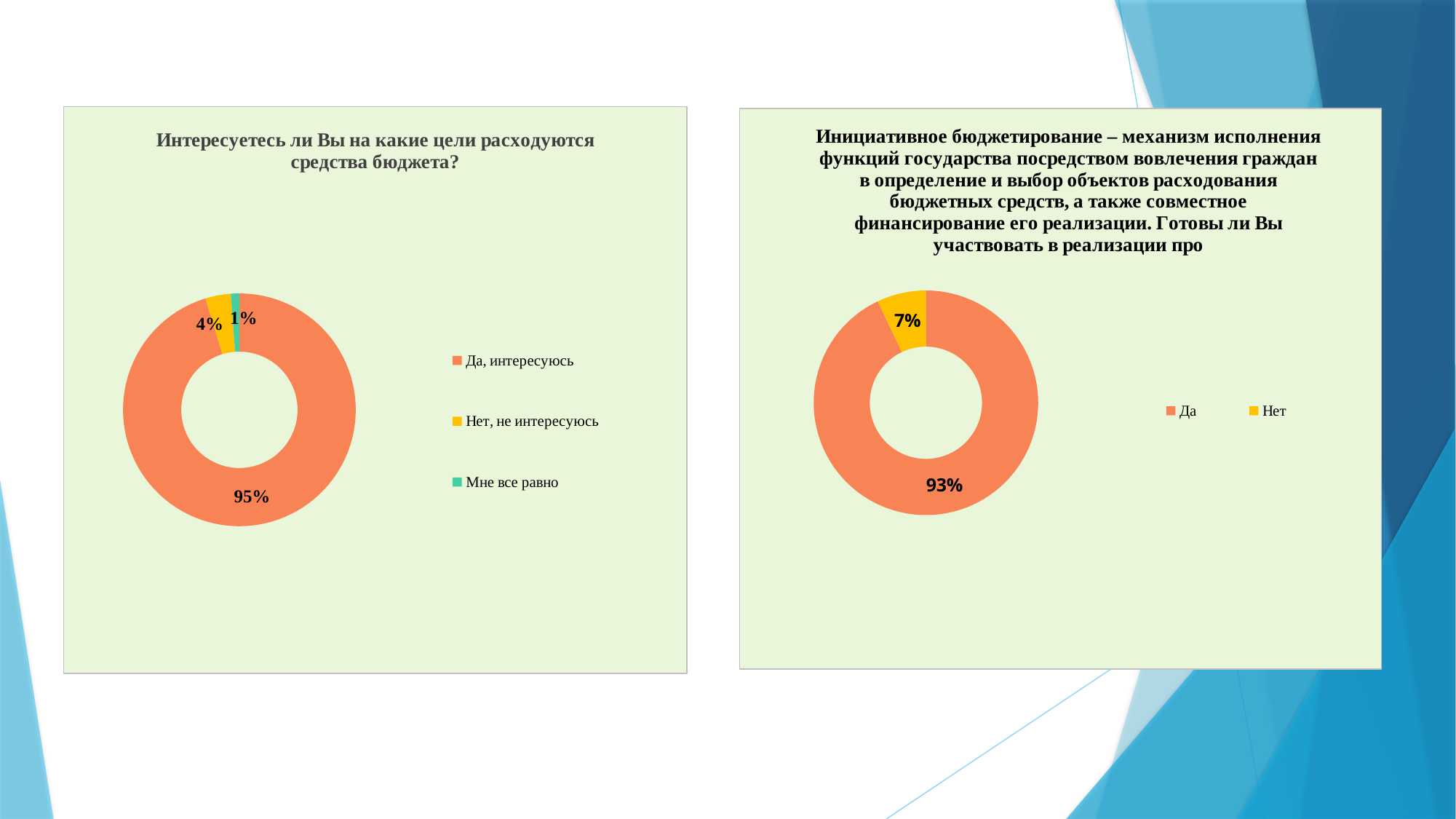
In the left chart, which category has the smallest share? Мне все равно In the left chart ("Интересуетесь ли Вы на какие цели расходуются средства бюджета?"), what share is labelled for "Да, интересуюсь"? 95% In the left chart, which category has the largest share? Да, интересуюсь In the right chart, how many categories does the legend list? 2 In the right chart, what colour is the "Нет" slice? Yellow In the right chart, what share is labelled for "Да"? 93% In the left chart, how many categories does the legend list? 3 In the left chart, what share is labelled for "Мне все равно"? 1% In the left chart, what is the difference between the shares for "Да, интересуюсь" and "Нет, не интересуюсь"? 91% In the right chart, what share is labelled for "Нет"? 7% In the left chart, what share is labelled for "Нет, не интересуюсь"? 4% What kind of chart is the right chart (about initiative budgeting)? Doughnut (pie) chart